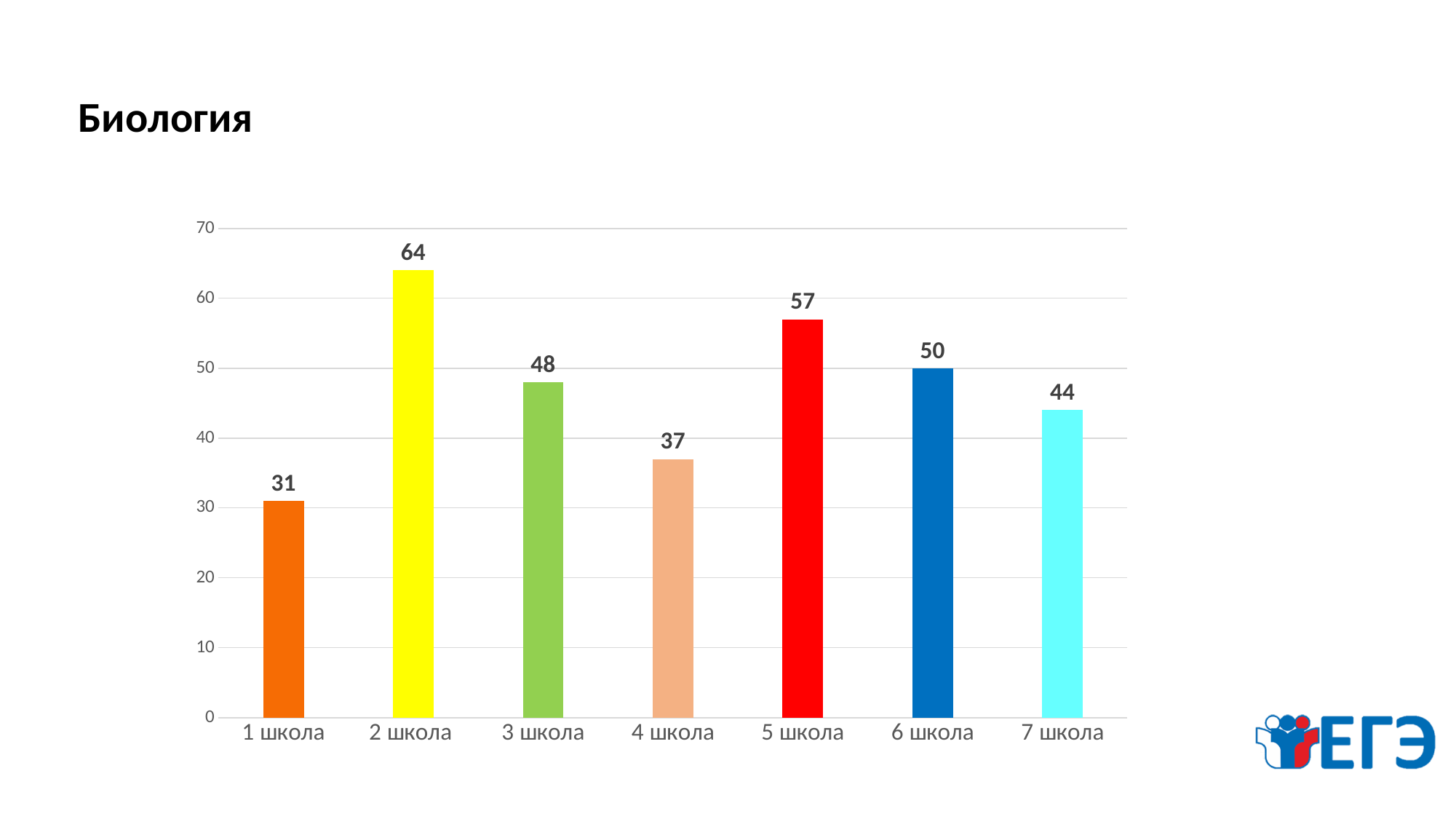
What is the value for 7 школа? 44 What kind of chart is shown on the slide? bar chart What is the difference between the values for 2 школа and 1 школа? 33 Which school has the lowest value? 1 школа How many schools are shown on the chart? 7 What is the value for 5 школа? 57 What is the value for 2 школа? 64 Which school has the highest value? 2 школа What is the difference between the values for 5 школа and 6 школа? 7 Which is larger, the value for 3 школа or the value for 4 школа? 3 школа Is the value for 6 школа greater or less than 40? greater What is the title of the slide? Биология